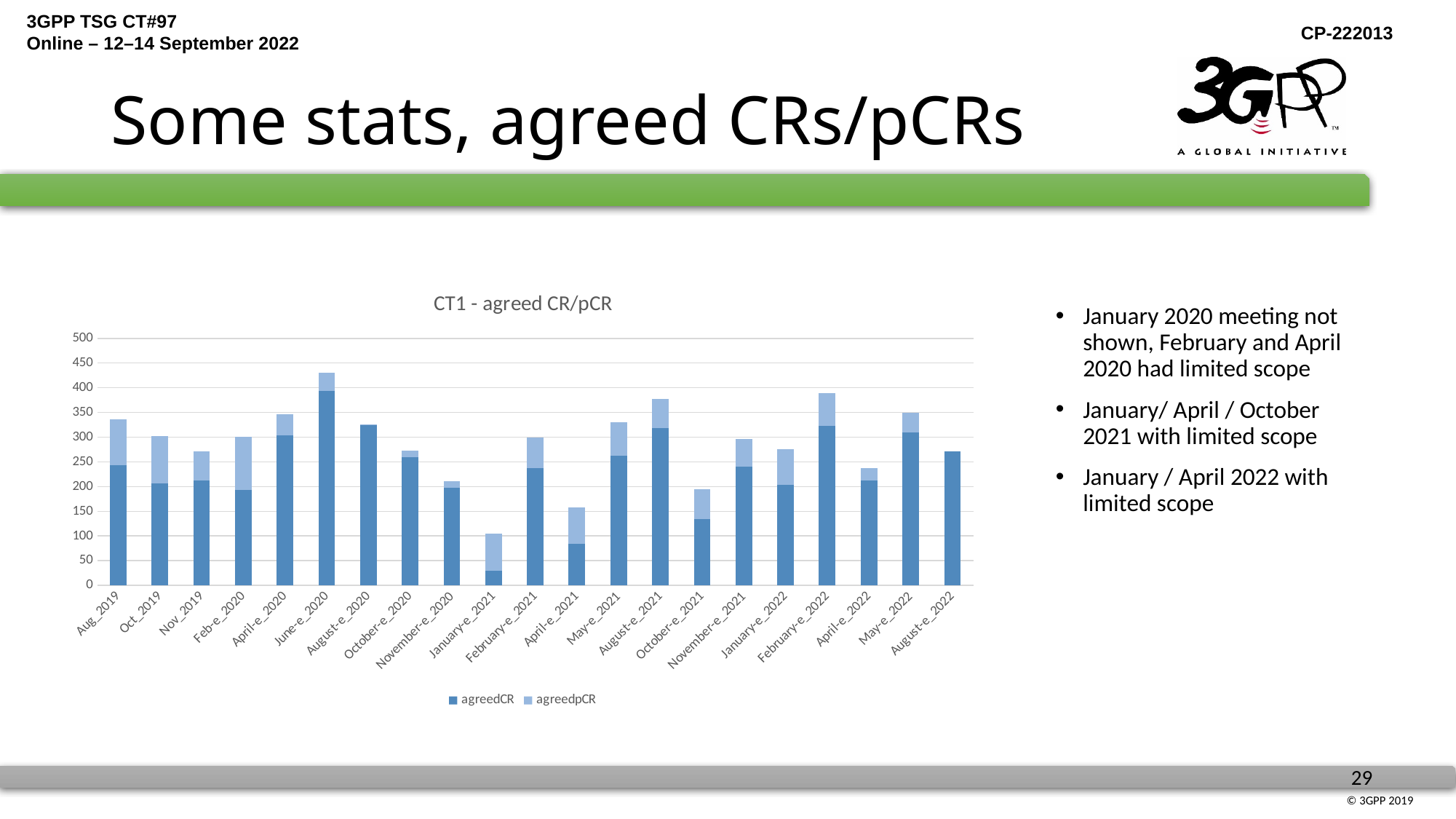
How many meeting categories are shown on the x axis? 21 Which meeting has the highest total stacked bar? June-e_2020 What is the title of the chart? CT1 - agreed CR/pCR Which has the larger agreedCR value, April-e_2021 or October-e_2021? October-e_2021 Which series is shown in the lighter blue colour? agreedpCR What kind of chart is shown on the slide? Stacked bar chart Is the total stacked bar for August-e_2022 greater or less than 300? less How many series does the chart legend list? 2 Is the agreedCR value for June-e_2020 greater or less than 350? greater Is the agreedCR value for January-e_2021 greater or less than 50? less Which meeting has the lowest total stacked bar? January-e_2021 Which has the larger total stacked bar, June-e_2020 or August-e_2021? June-e_2020